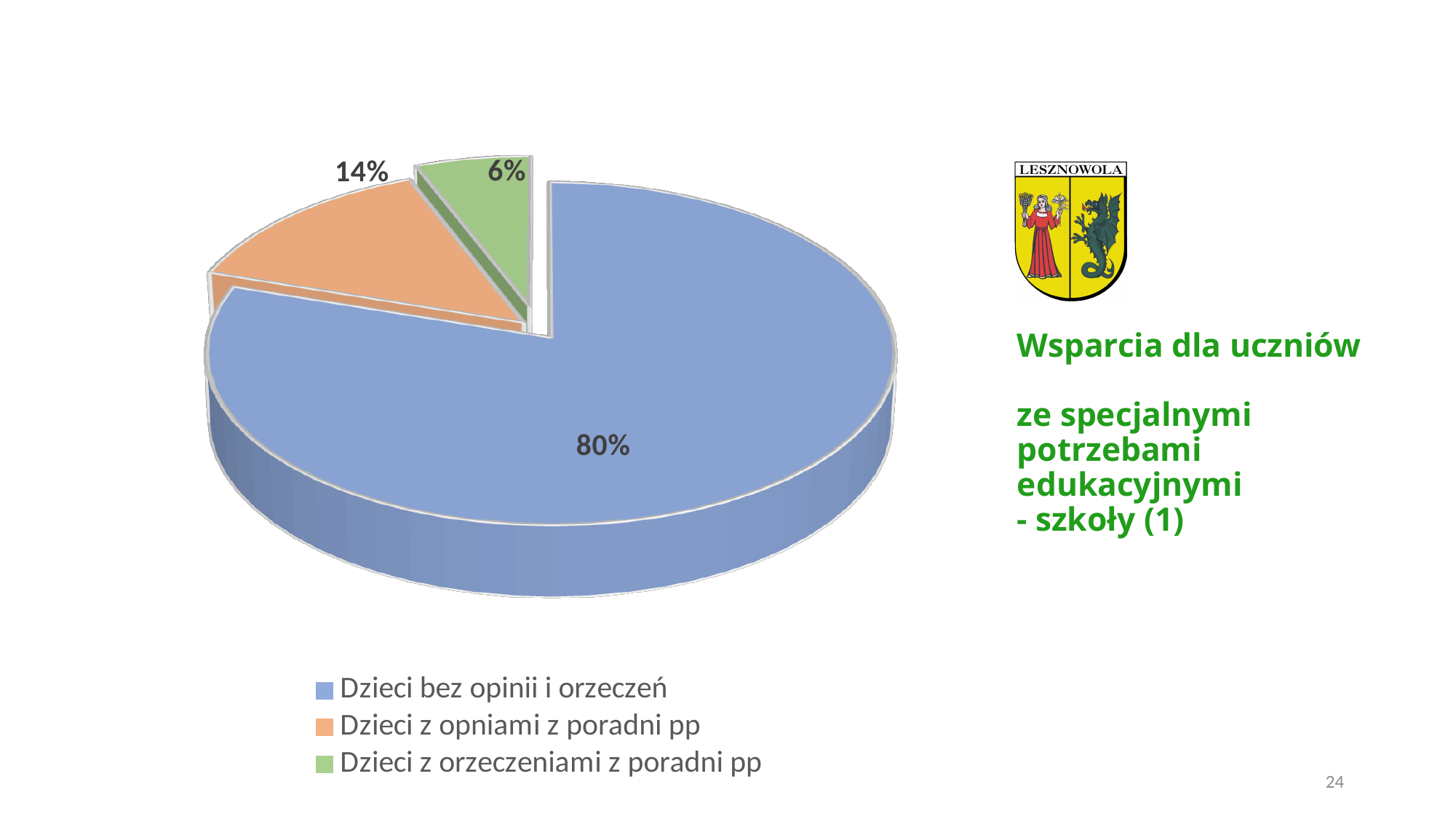
Which category has the largest slice of the pie? Dzieci bez opinii i orzeczeń What share of the pie is labelled "Dzieci z opniami z poradni pp"? 14% How many entries does the legend list? 3 What share of the pie is labelled "Dzieci z orzeczeniami z poradni pp"? 6% Which is larger: the slice for "Dzieci z opniami z poradni pp" or the slice for "Dzieci z orzeczeniami z poradni pp"? Dzieci z opniami z poradni pp What share of the pie is labelled "Dzieci bez opinii i orzeczeń"? 80% What colour is the slice for "Dzieci z orzeczeniami z poradni pp"? green What is the difference in percentage points between "Dzieci z opniami z poradni pp" and "Dzieci z orzeczeniami z poradni pp"? 8 What kind of chart is shown on the slide? pie chart Which category has the smallest slice of the pie? Dzieci z orzeczeniami z poradni pp How many slices does the pie chart have? 3 What is the difference in percentage points between "Dzieci bez opinii i orzeczeń" and "Dzieci z opniami z poradni pp"? 66